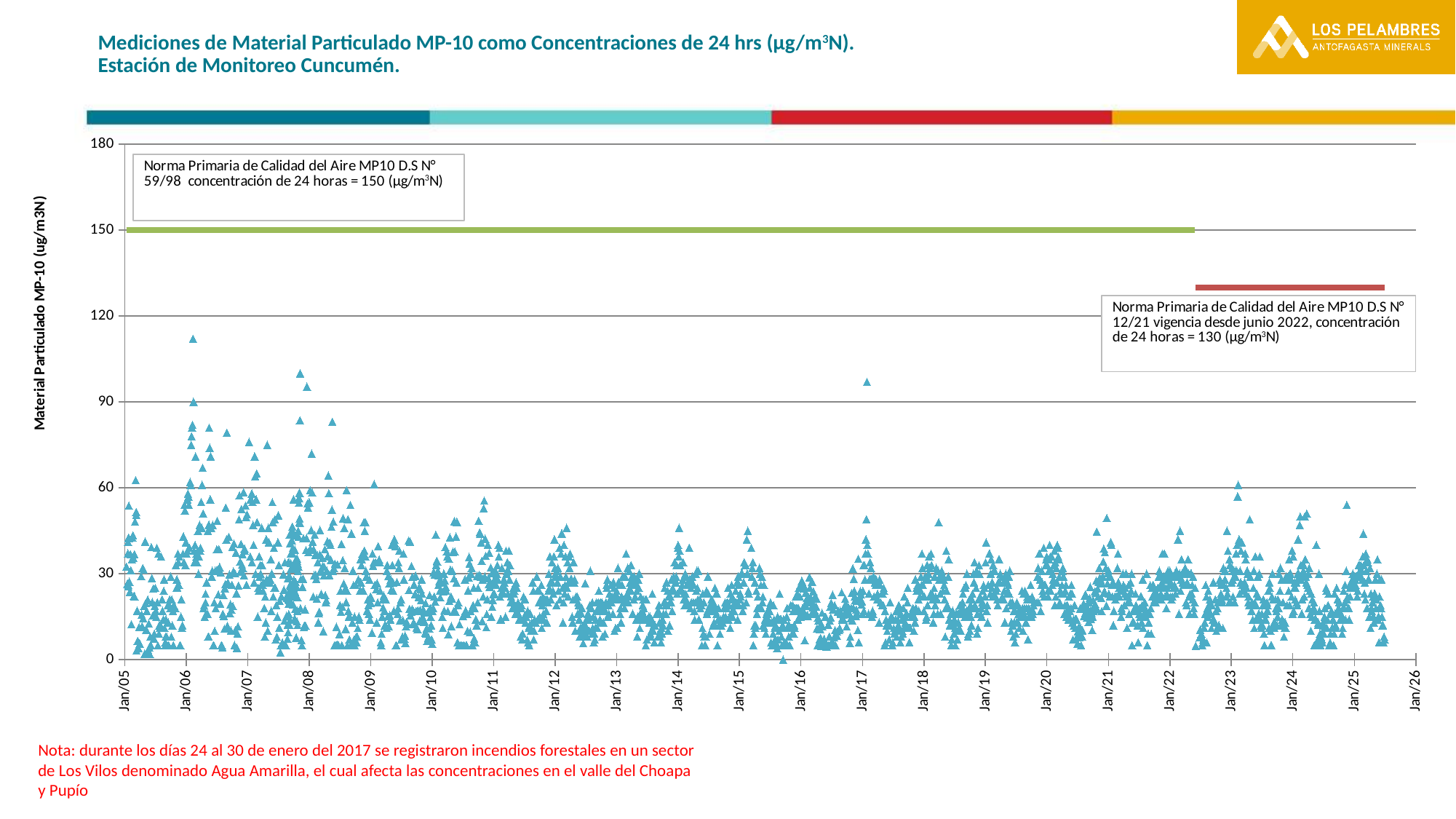
What is the 24-hour concentration limit of the Norma Primaria de Calidad del Aire MP10 D.S N° 59/98 shown by the green line? 150 (µg/m³N) Is the highest MP-10 measurement plotted on the chart greater or less than 120? less What kind of chart is shown on the slide? scatter chart Is the highest MP-10 measurement plotted on the chart greater or less than 90? greater Is the peak measurement near Jan/17 greater or less than 90? greater Since when has the D.S N° 12/21 norm been in force according to the text box? junio 2022 What is the 24-hour concentration limit of the Norma Primaria de Calidad del Aire MP10 D.S N° 12/21 shown by the red line? 130 (µg/m³N) What is the highest value shown on the y axis? 180 Which of the two norm lines is higher, the green D.S N° 59/98 line or the red D.S N° 12/21 line? the green D.S N° 59/98 line What is the first date label on the x axis? Jan/05 What is the difference between the D.S N° 59/98 limit (150) and the D.S N° 12/21 limit (130)? 20 Are the highest peaks in the early years (2005–2009) higher or lower than the peaks in the later years (2018–2025)? higher